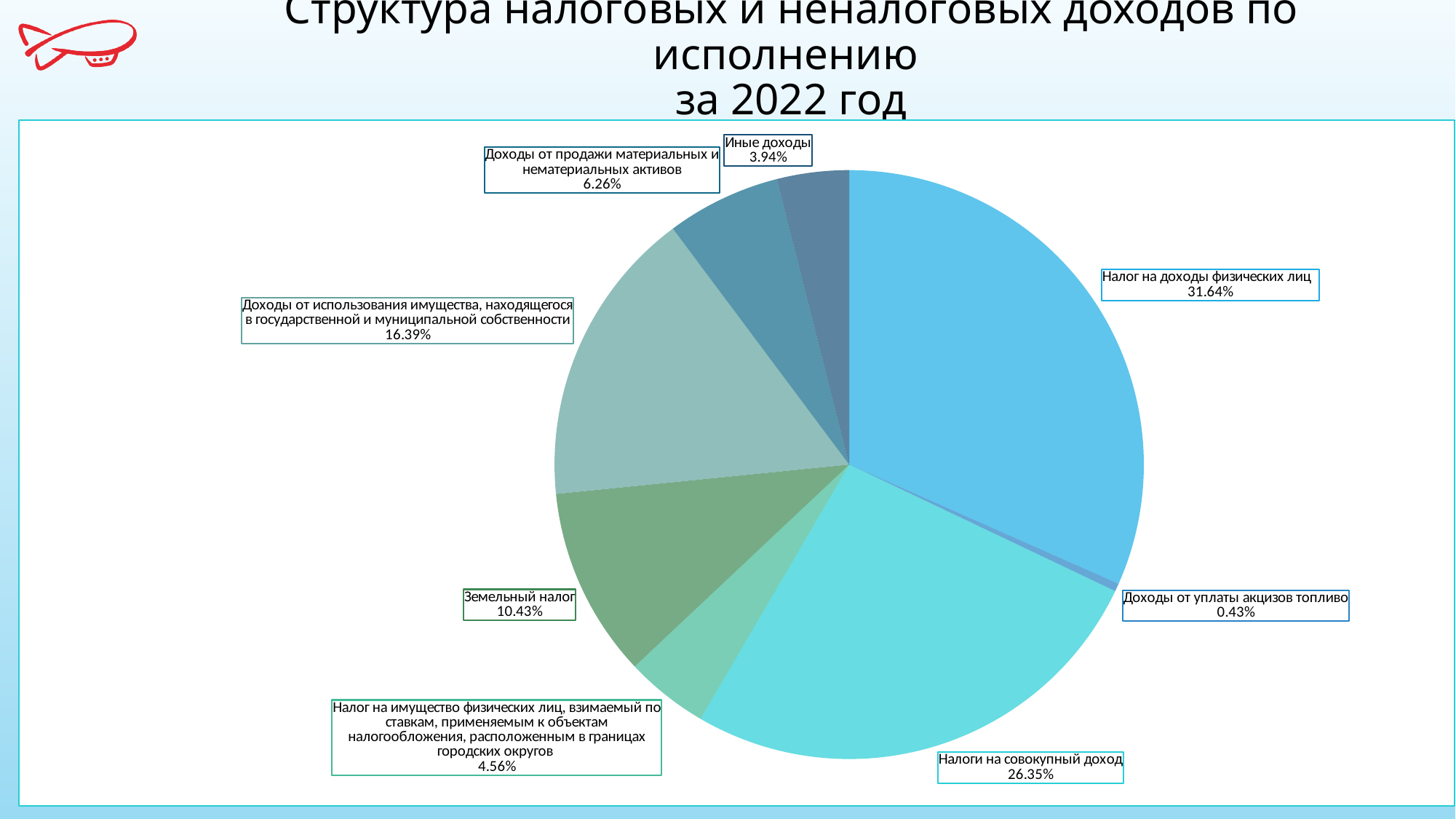
What type of chart is shown on the slide? pie chart What is the difference between the shares of "Налог на доходы физических лиц" and "Налоги на совокупный доход"? 5.29% What share does "Налог на доходы физических лиц" have in the pie chart? 31.64% What percentage is shown for "Земельный налог"? 10.43% What is the title of the slide containing the pie chart? Структура налоговых и неналоговых доходов по исполнению за 2022 год Which category has the largest slice of the pie chart? Налог на доходы физических лиц What share is shown for "Иные доходы"? 3.94% What is the value shown for "Налоги на совокупный доход"? 26.35% Which category has the smallest slice of the pie chart? Доходы от уплаты акцизов топливо How many categories (slices) does the pie chart contain? 8 Which is larger: "Доходы от использования имущества, находящегося в государственной и муниципальной собственности" or "Земельный налог"? Доходы от использования имущества, находящегося в государственной и муниципальной собственности What is the value for "Доходы от уплаты акцизов топливо"? 0.43%